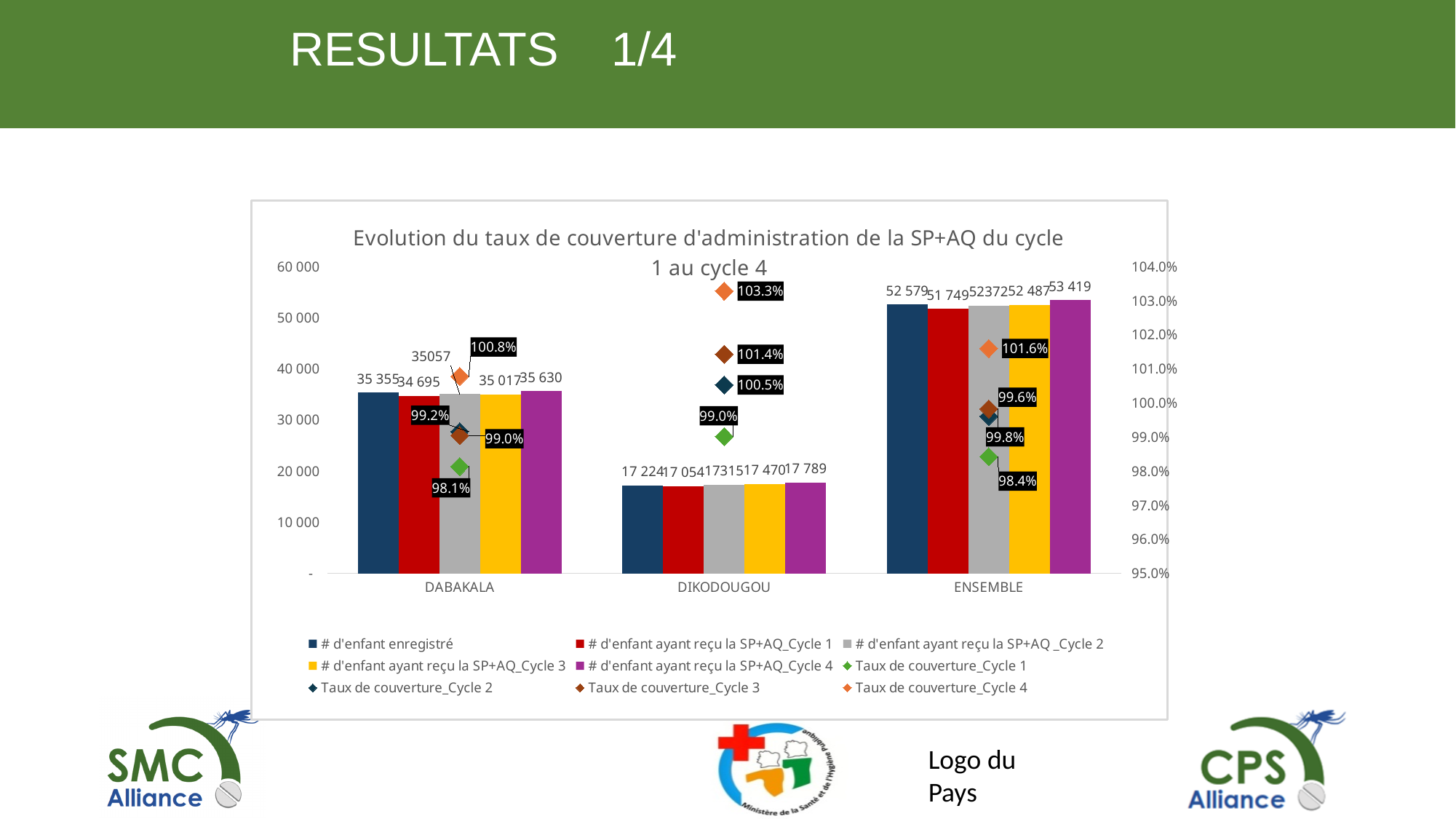
Does the coverage rate for DIKODOUGOU rise or fall from Cycle 1 to Cycle 4? rise How many series does the legend list? 9 How many children received SP+AQ in Cycle 4 in DIKODOUGOU? 17 789 For DABAKALA, which is larger: the number of children who received SP+AQ in Cycle 1 or in Cycle 4? Cycle 4 For DIKODOUGOU, by how many percentage points does the Cycle 4 coverage rate exceed the Cycle 1 coverage rate? 4.3 percentage points What is the difference between the Cycle 4 count (53 419) and '# d'enfant enregistré' (52 579) for ENSEMBLE? 840 What is the 'Taux de couverture_Cycle 4' for DIKODOUGOU? 103.3% What is the 'Taux de couverture_Cycle 1' for ENSEMBLE? 98.4% How many categories are shown on the x axis? 3 What is the value of '# d'enfant enregistré' for DABAKALA? 35 355 Which category has the lowest 'Taux de couverture_Cycle 1'? DABAKALA Which category has the highest number of '# d'enfant enregistré'? ENSEMBLE